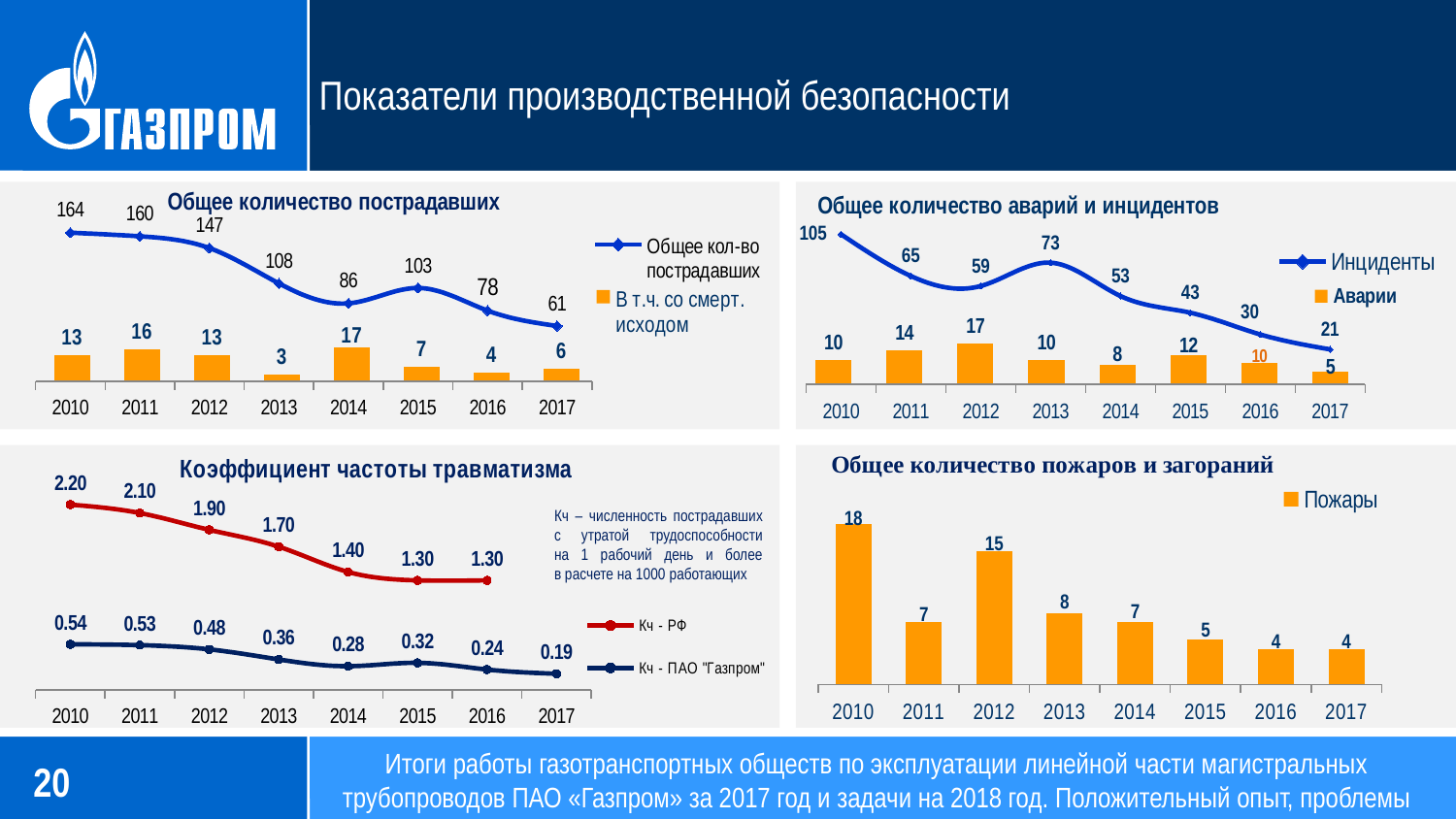
In the chart 'Общее количество аварий и инцидентов', what is the value of 'Аварии' for 2012? 17 What kind of chart is 'Общее количество пожаров и загораний'? bar chart In the chart 'Общее количество аварий и инцидентов', is the 'Инциденты' value for 2013 larger or smaller than the value for 2012? larger In the chart 'Общее количество аварий и инцидентов', which year has the lowest value for 'Инциденты'? 2017 In the chart 'Общее количество пожаров и загораний', what is the difference between the values for 2012 and 2013? 7 In the chart 'Общее количество пострадавших', what is the value of 'Общее кол-во пострадавших' for 2013? 108 In the chart 'Коэффициент частоты травматизма', what is the value of 'Кч - ПАО "Газпром"' for 2017? 0.19 In the chart 'Коэффициент частоты травматизма', how many series does the legend list? 2 In the chart 'Общее количество пострадавших', which year has the highest value for 'В т.ч. со смерт. исходом'? 2014 In the chart 'Общее количество пострадавших', what is the difference between the 'Общее кол-во пострадавших' values for 2010 and 2017? 103 In the chart 'Общее количество пожаров и загораний', which year has the highest value? 2010 In the chart 'Коэффициент частоты травматизма', what is the value of 'Кч - РФ' for 2014? 1.40